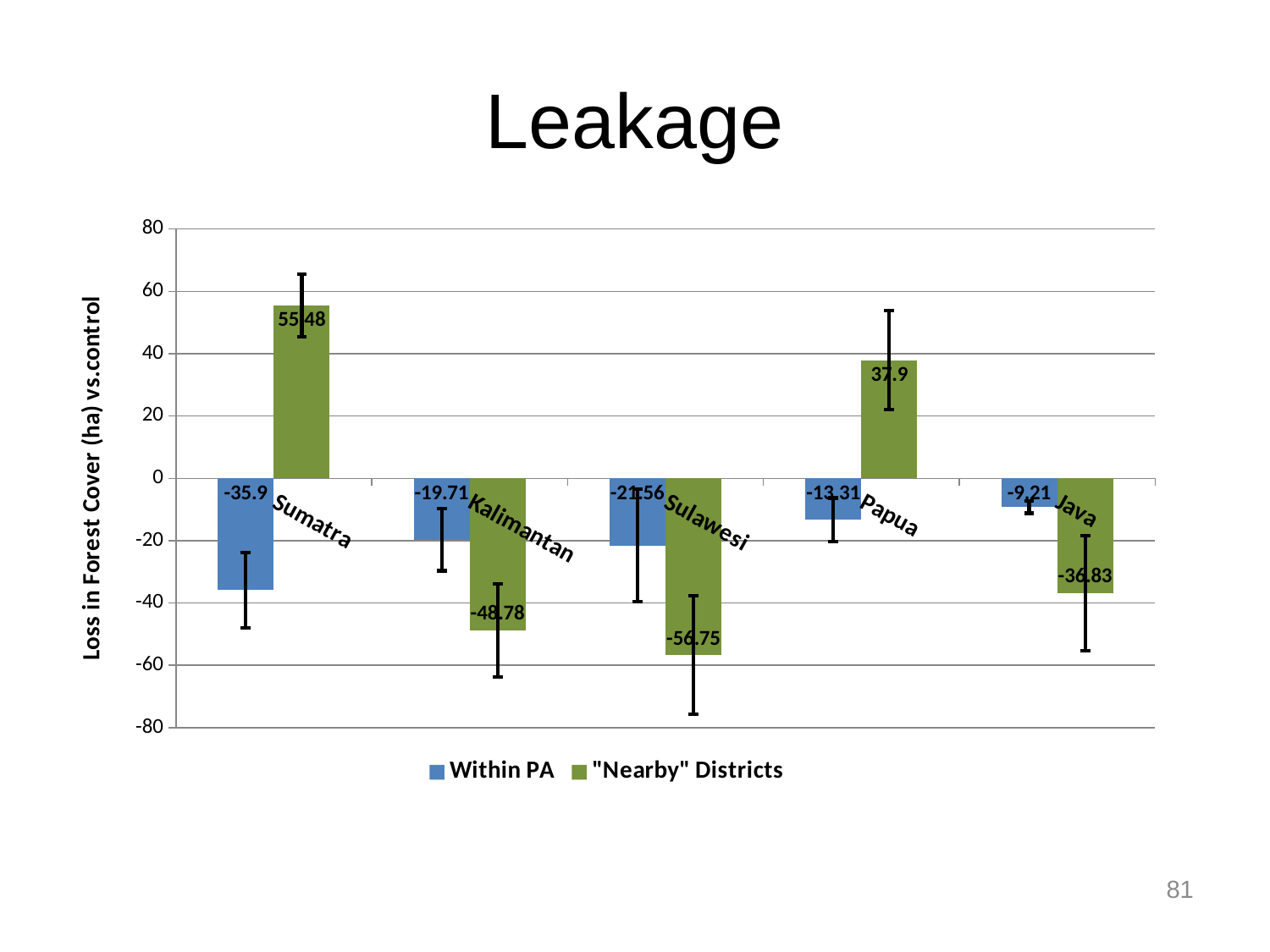
What is the Within PA value for Java? -9.21 What is the difference between the "Nearby" Districts value and the Within PA value for Sumatra? 91.38 How many regions are shown on the x axis? 5 What is the "Nearby" Districts value for Papua? 37.9 Which is larger, the Within PA value for Kalimantan or the Within PA value for Papua? Papua Which region has the lowest "Nearby" Districts value? Sulawesi How many series does the legend list? 2 What is the "Nearby" Districts value for Sumatra? 55.48 What is the Within PA value for Sumatra? -35.9 Which region has the highest "Nearby" Districts value? Sumatra What kind of chart is shown on the slide? bar chart What is the "Nearby" Districts value for Kalimantan? -48.78